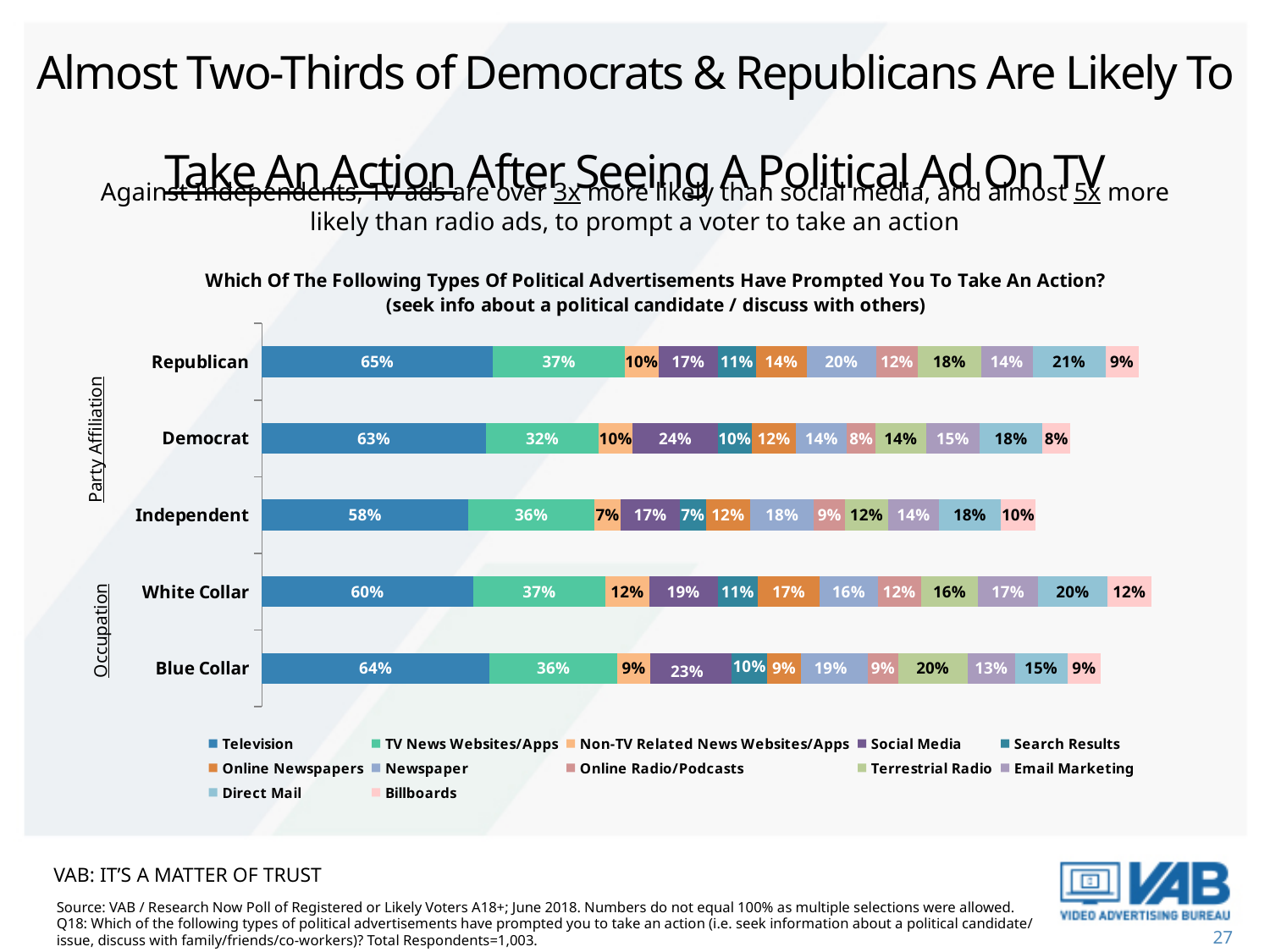
What is the Direct Mail value for Republicans? 21% Which category has the lowest Television value? Independent What is the Billboards value for White Collar respondents? 12% What is the Social Media value for Democrats? 24% What is the difference between the Television values for Republicans and Independents? 7 percentage points What kind of chart is shown on the slide? Stacked horizontal bar chart What percentage of Republicans said a Television ad prompted them to take an action? 65% Which category has the highest Television value? Republican How many series does the legend list? 12 Which is larger, the Social Media value for Democrats or for Republicans? Democrat How many categories (bars) are shown in the chart? 5 Which series is listed first in the legend? Television